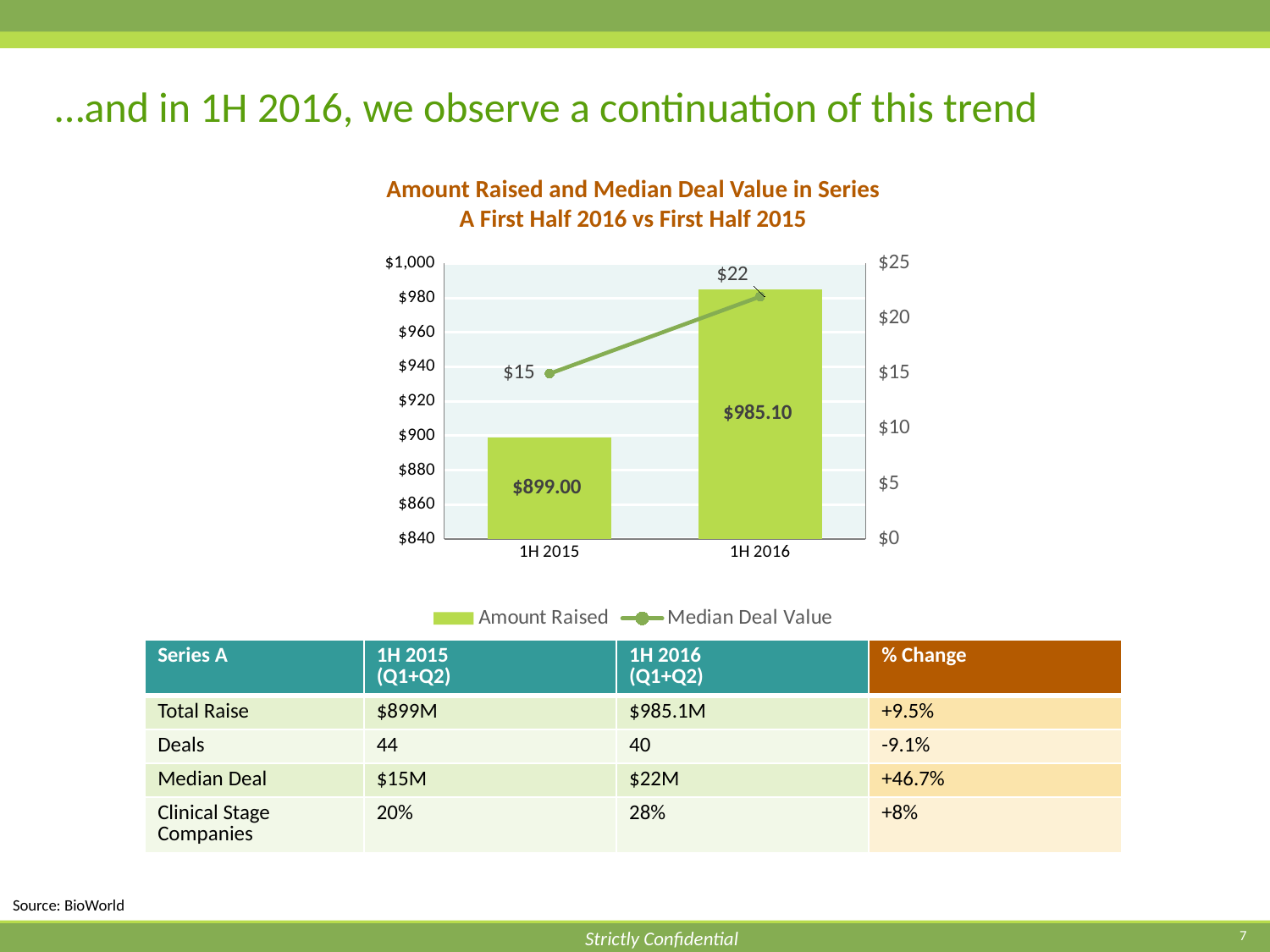
Which period has the lower Median Deal Value? 1H 2015 What is the Median Deal Value for 1H 2016? $22 Which period has the higher Amount Raised? 1H 2016 Does the Median Deal Value rise or fall from 1H 2015 to 1H 2016? rise Is the Median Deal Value for 1H 2016 greater or less than $20? greater How many periods are shown on the x axis of the chart? 2 What is the difference in Median Deal Value between 1H 2016 and 1H 2015? $7 What is the Amount Raised for 1H 2015? $899.00 How many series does the chart legend list? 2 What is the difference in Amount Raised between 1H 2016 and 1H 2015? $86.10 What is the Median Deal Value for 1H 2015? $15 What is the Amount Raised for 1H 2016? $985.10